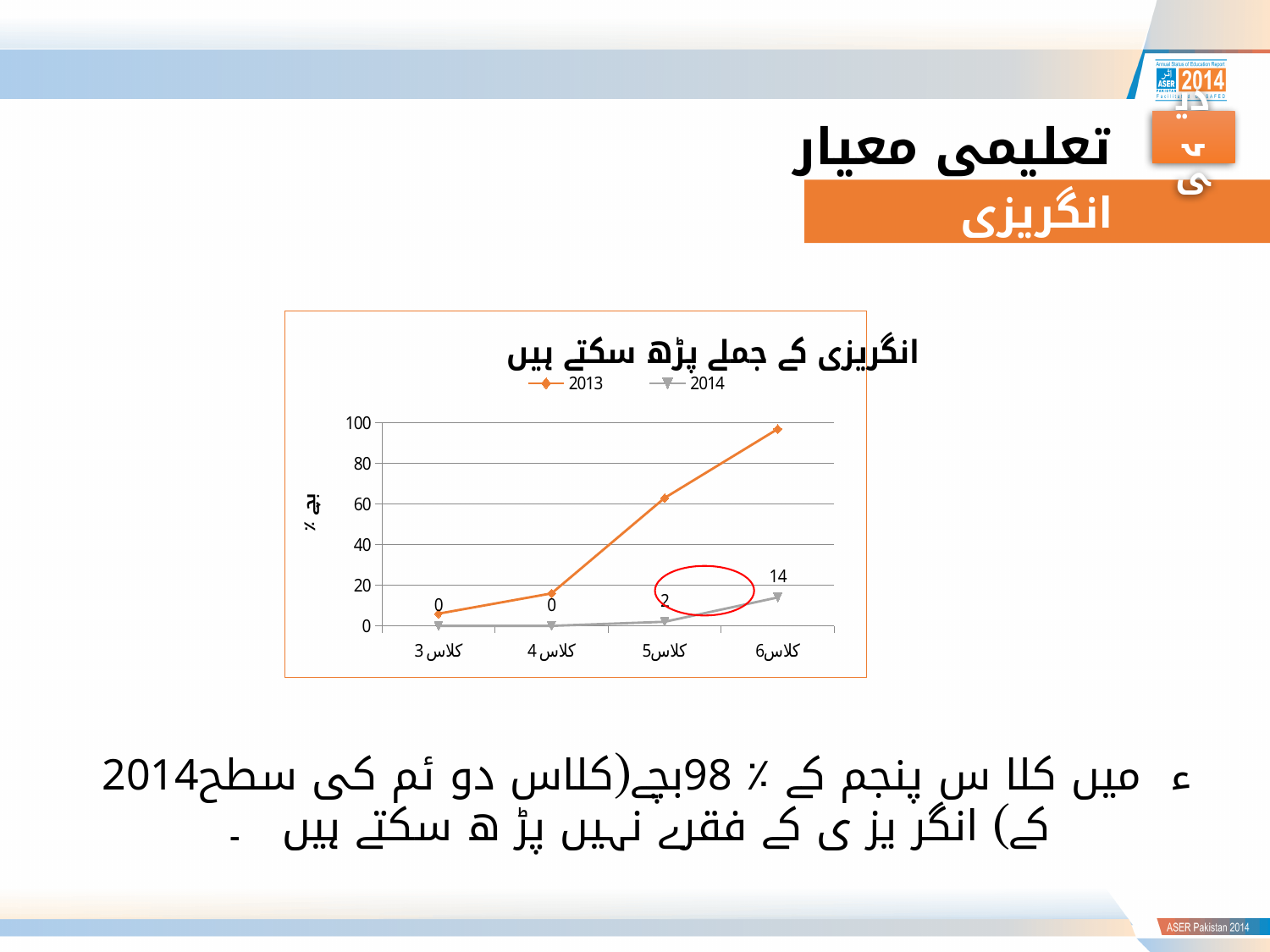
Which category has the highest value for the 2014 series? کلاس6 How many series does the legend list? 2 What is the value for the 2014 series at کلاس5? 2 Is the value for the 2013 series at کلاس 4 greater or less than 40? less At کلاس6, which series has the larger value, 2013 or 2014? 2013 What is the difference between the 2014 values for کلاس6 and کلاس5? 12 Is the value for the 2013 series at کلاس6 greater or less than 80? greater What is the value for the 2014 series at کلاس 3? 0 What kind of chart is shown on the slide? Line chart What is the value for the 2014 series at کلاس6? 14 How many categories are shown on the x axis? 4 Is the value for the 2013 series at کلاس5 greater or less than 40? greater